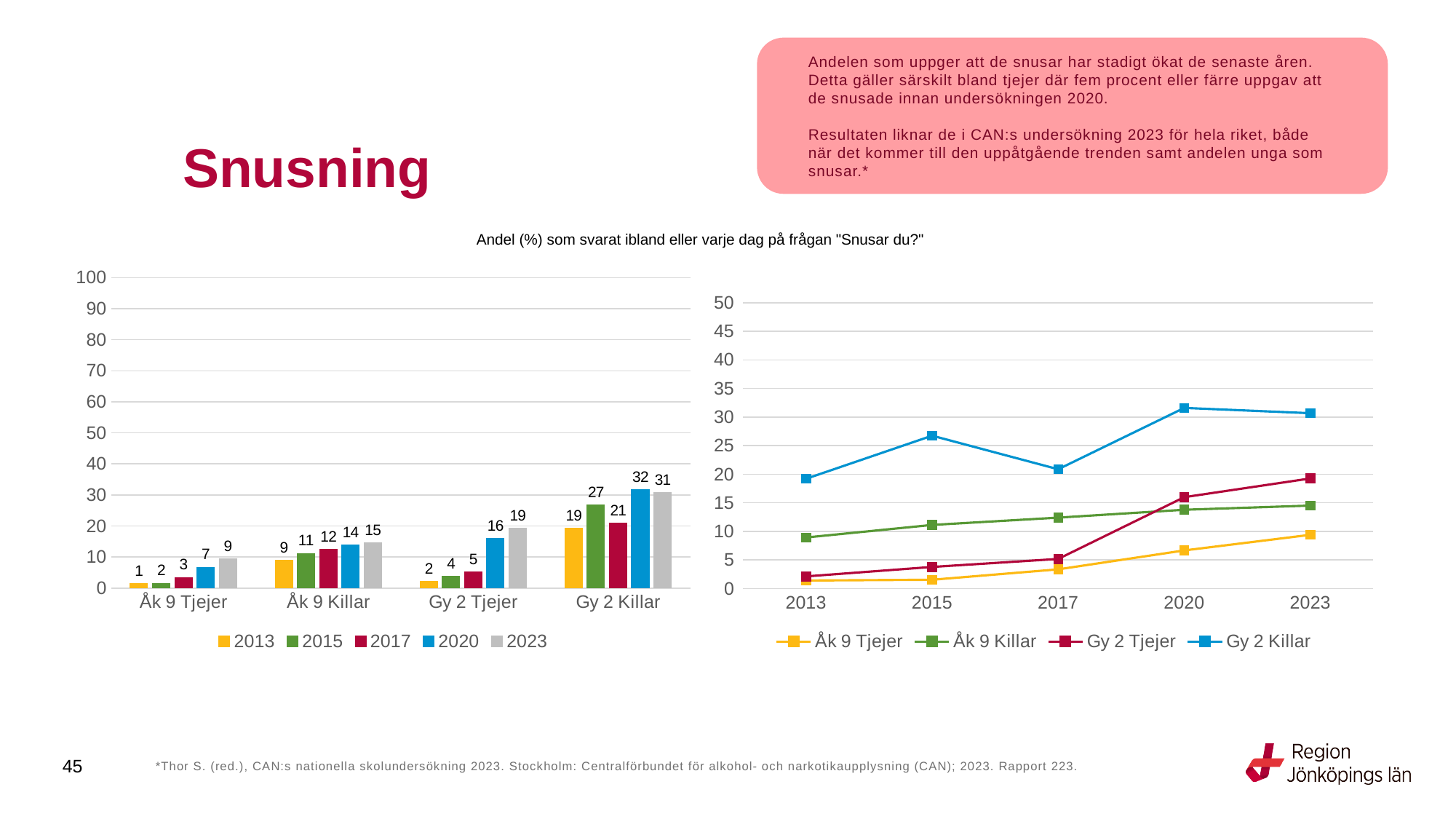
In the line chart on the right, is the value for Gy 2 Killar in 2020 greater or less than 30? greater In the bar chart on the left, what is the difference between the 2023 and 2013 values for Gy 2 Tjejer? 17 In the line chart on the right, does the Åk 9 Killar series rise or fall from 2013 to 2023? rise In the bar chart on the left, what is the value for Gy 2 Killar in 2020? 32 In the bar chart on the left, which category has the lowest value for 2015? Åk 9 Tjejer What kind of chart is the chart on the right? line chart How many categories are shown on the x axis of the bar chart on the left? 4 In the bar chart on the left, what is the value for Åk 9 Tjejer in 2013? 1 In the bar chart on the left, which category has the highest value for 2023? Gy 2 Killar In the bar chart on the left, what is the value for Gy 2 Tjejer in 2023? 19 How many series does the legend of the bar chart on the left list? 5 In the bar chart on the left, which is larger for Gy 2 Killar: the 2015 value or the 2017 value? 2015